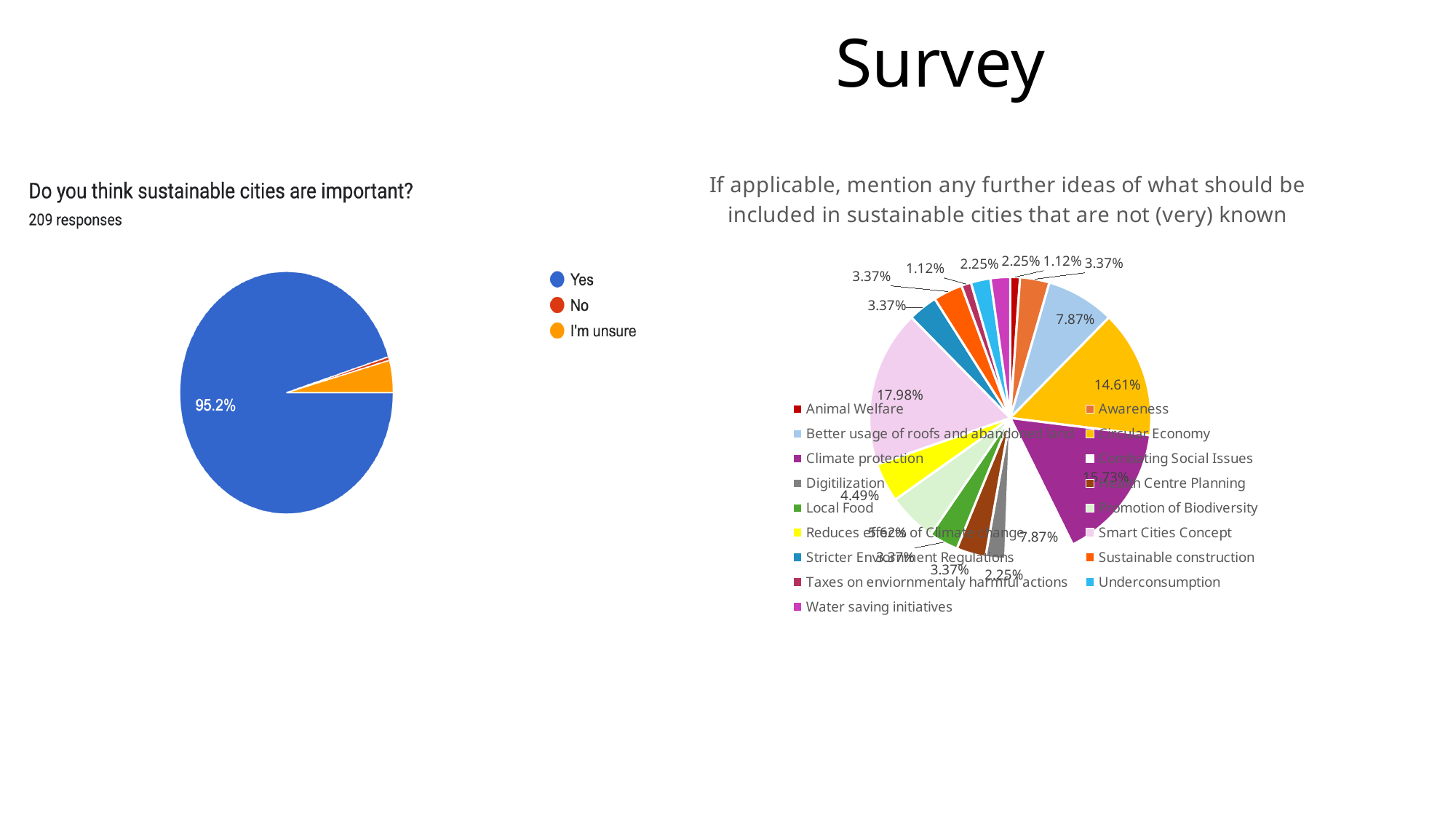
How many response options does the legend of the left chart 'Do you think sustainable cities are important?' list? 3 On the right chart about further ideas for sustainable cities, which is larger: Climate protection or Circular Economy? Climate protection On the left chart 'Do you think sustainable cities are important?', which response has the largest share? Yes On the right chart about further ideas for sustainable cities, what share does Climate protection have? 15.73% What kind of chart is the left chart 'Do you think sustainable cities are important?'? Pie chart How many categories does the legend of the right chart about further ideas for sustainable cities list? 17 How many responses does the left chart 'Do you think sustainable cities are important?' report? 209 responses On the right chart about further ideas for sustainable cities, what share does Smart Cities Concept have? 17.98% On the right chart about further ideas for sustainable cities, what share does Circular Economy have? 14.61% On the right chart about further ideas for sustainable cities, what is the difference between the shares of Smart Cities Concept and Climate protection? 2.25% On the left chart 'Do you think sustainable cities are important?', what percentage of respondents answered Yes? 95.2% On the right chart about further ideas for sustainable cities, which category has the largest slice? Smart Cities Concept